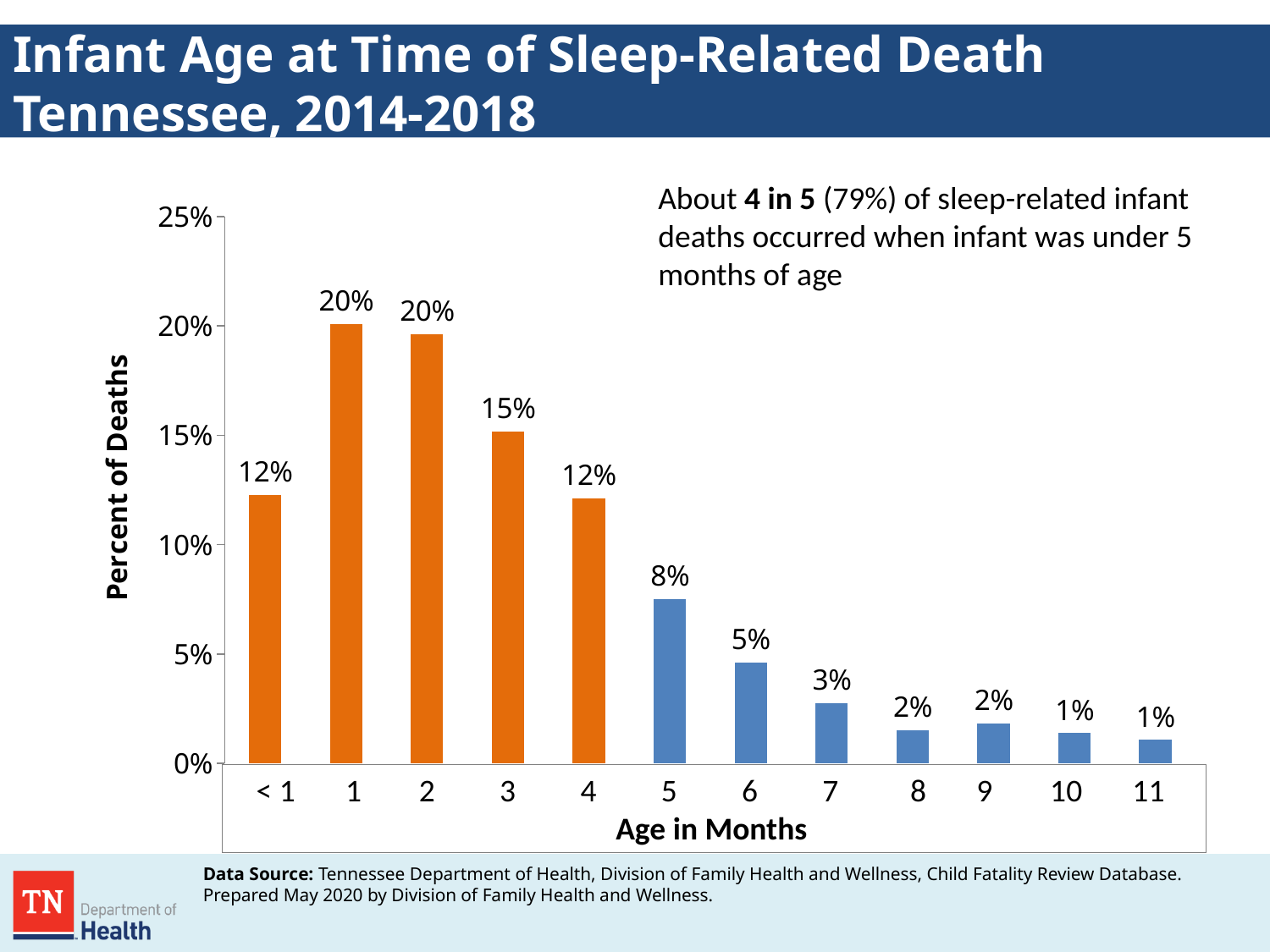
What is the difference between the percent of deaths at 5 months and at 6 months? 3% Which age has a higher percent of deaths, 6 months or 7 months? 6 months What percent of deaths is shown for infants aged < 1 month? 12% What is the difference between the percent of deaths at 3 months and at 4 months? 3% What is the label of the y axis? Percent of Deaths What kind of chart is shown on the slide? bar chart How many age categories are shown on the x axis? 12 What percent of deaths is shown for infants aged 3 months? 15% What percent of deaths is shown for infants aged 5 months? 8% What percent of deaths is shown for infants aged 8 months? 2% From 1 month to 11 months, do the percent of deaths values rise or fall along the x axis? fall Is the percent of deaths for infants aged 1 month greater or less than 15%? greater